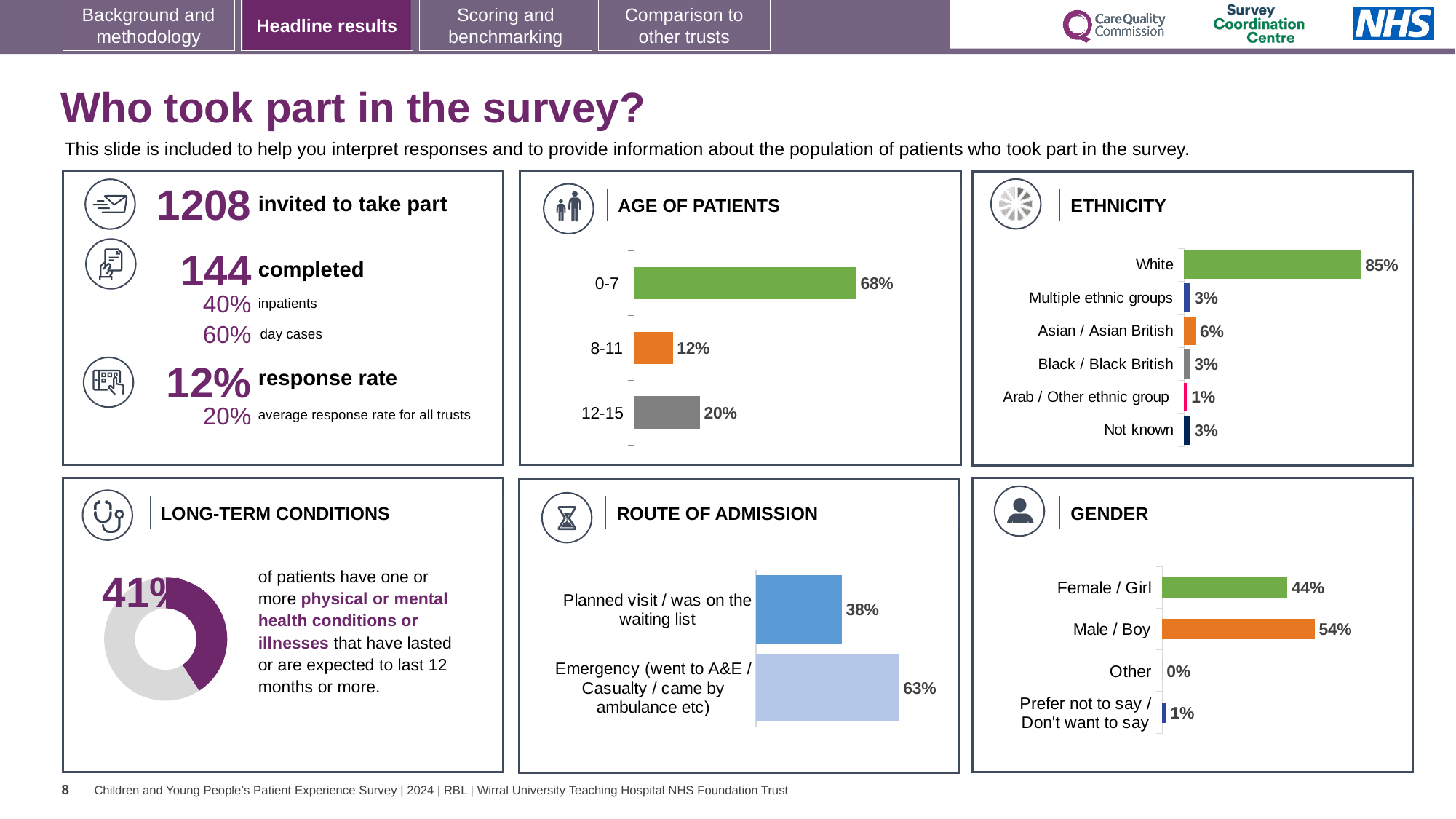
In the AGE OF PATIENTS chart, what is the difference between the 0-7 and 12-15 values? 48% In the GENDER chart, what is the difference between Male / Boy and Female / Girl? 10% In the ETHNICITY chart, what is the value for Asian / Asian British? 6% In the LONG-TERM CONDITIONS chart, what share of patients have one or more long-term conditions? 41% In the GENDER chart, what is the value for Male / Boy? 54% What kind of chart is the LONG-TERM CONDITIONS chart? Doughnut chart In the AGE OF PATIENTS chart, which age group has the lowest value? 8-11 In the ETHNICITY chart, which category has the highest value? White In the ROUTE OF ADMISSION chart, what is the value for Emergency (went to A&E / Casualty / came by ambulance etc)? 63% In the ROUTE OF ADMISSION chart, which is larger: Planned visit / was on the waiting list or Emergency? Emergency (went to A&E / Casualty / came by ambulance etc) In the AGE OF PATIENTS chart, what is the value for the 0-7 age group? 68% How many categories are shown in the ETHNICITY chart? 6